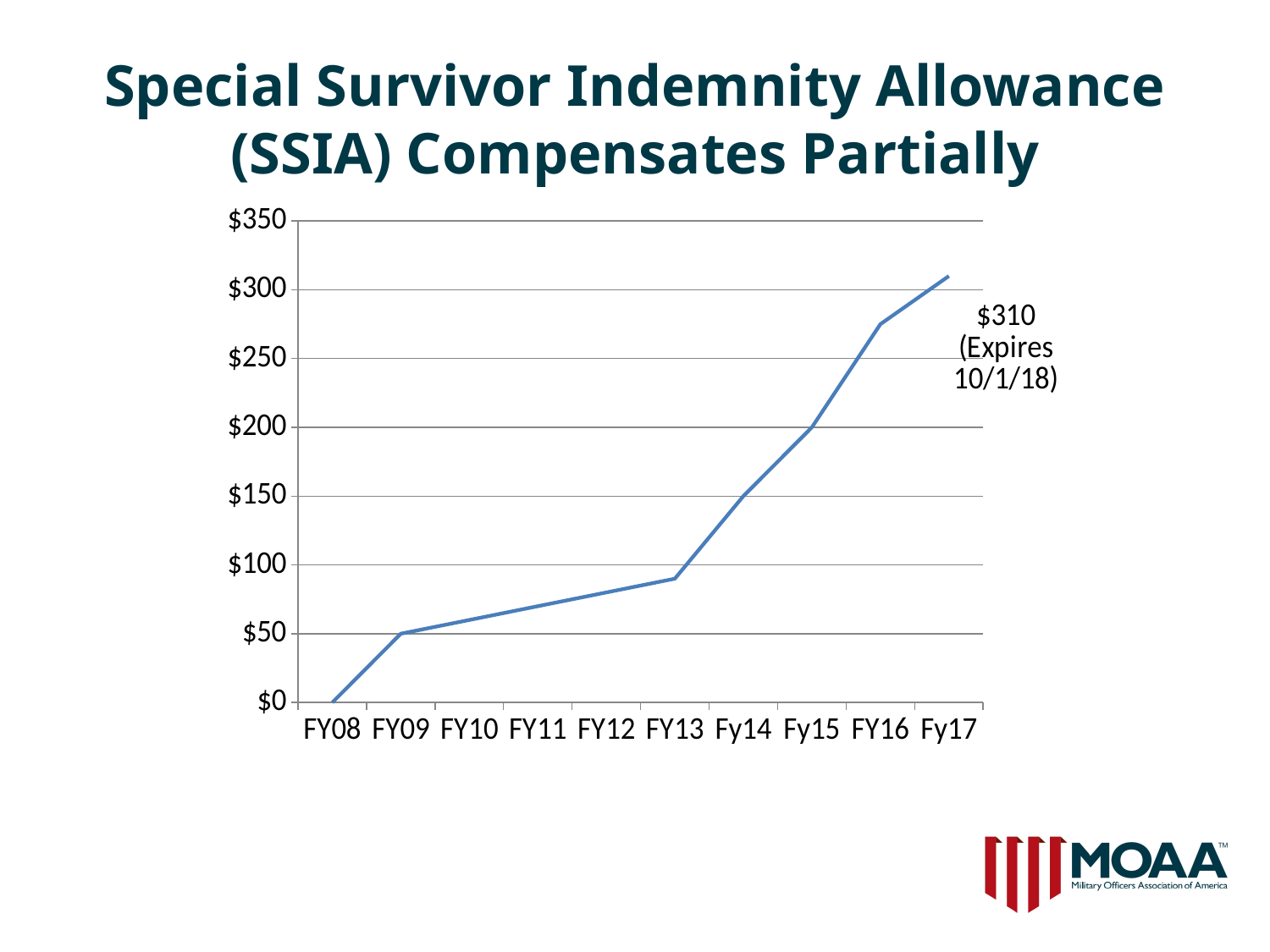
Which fiscal year has the lowest SSIA value? FY08 Which fiscal year has the highest SSIA value? Fy17 Do the SSIA values rise or fall from FY08 to Fy17? rise What is the SSIA value for Fy15? $200 Is the value for FY16 greater or less than $250? greater Is the value for FY13 greater or less than $100? less What is the SSIA value for Fy17? $310 What is the SSIA value for FY08? $0 What kind of chart is shown on the slide? line chart What is the SSIA value for FY09? $50 What is the difference between the Fy17 value and the Fy15 value? $110 How many fiscal years are plotted on the x axis? 10